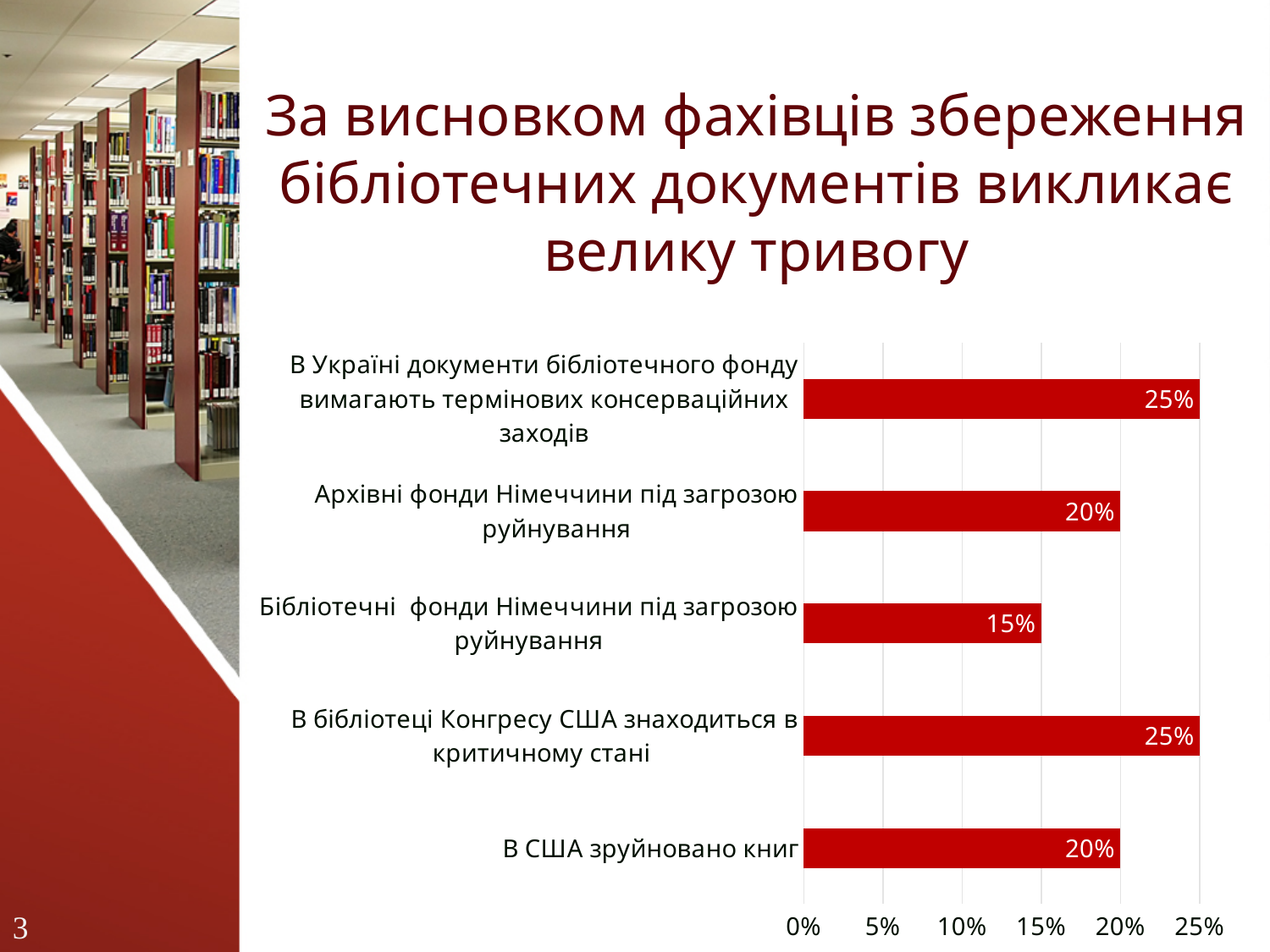
What is the difference between the value for "В Україні документи бібліотечного фонду вимагають термінових консерваційних заходів" and the value for "Бібліотечні фонди Німеччини під загрозою руйнування"? 10% What value is shown for "В США зруйновано книг"? 20% What value is shown for "Архівні фонди Німеччини під загрозою руйнування"? 20% Which is larger: the value for "Архівні фонди Німеччини під загрозою руйнування" or the value for "Бібліотечні фонди Німеччини під загрозою руйнування"? Архівні фонди Німеччини під загрозою руйнування How many categories are shown in the chart? 5 Which category has the lowest value? Бібліотечні фонди Німеччини під загрозою руйнування What value is shown for "Бібліотечні фонди Німеччини під загрозою руйнування"? 15% What value is shown for "В бібліотеці Конгресу США знаходиться в критичному стані"? 25% What kind of chart is shown on the slide? bar chart What colour are the bars in the chart? red What is the highest value shown on the x axis? 25% Is the value for "В США зруйновано книг" greater or less than 15%? greater